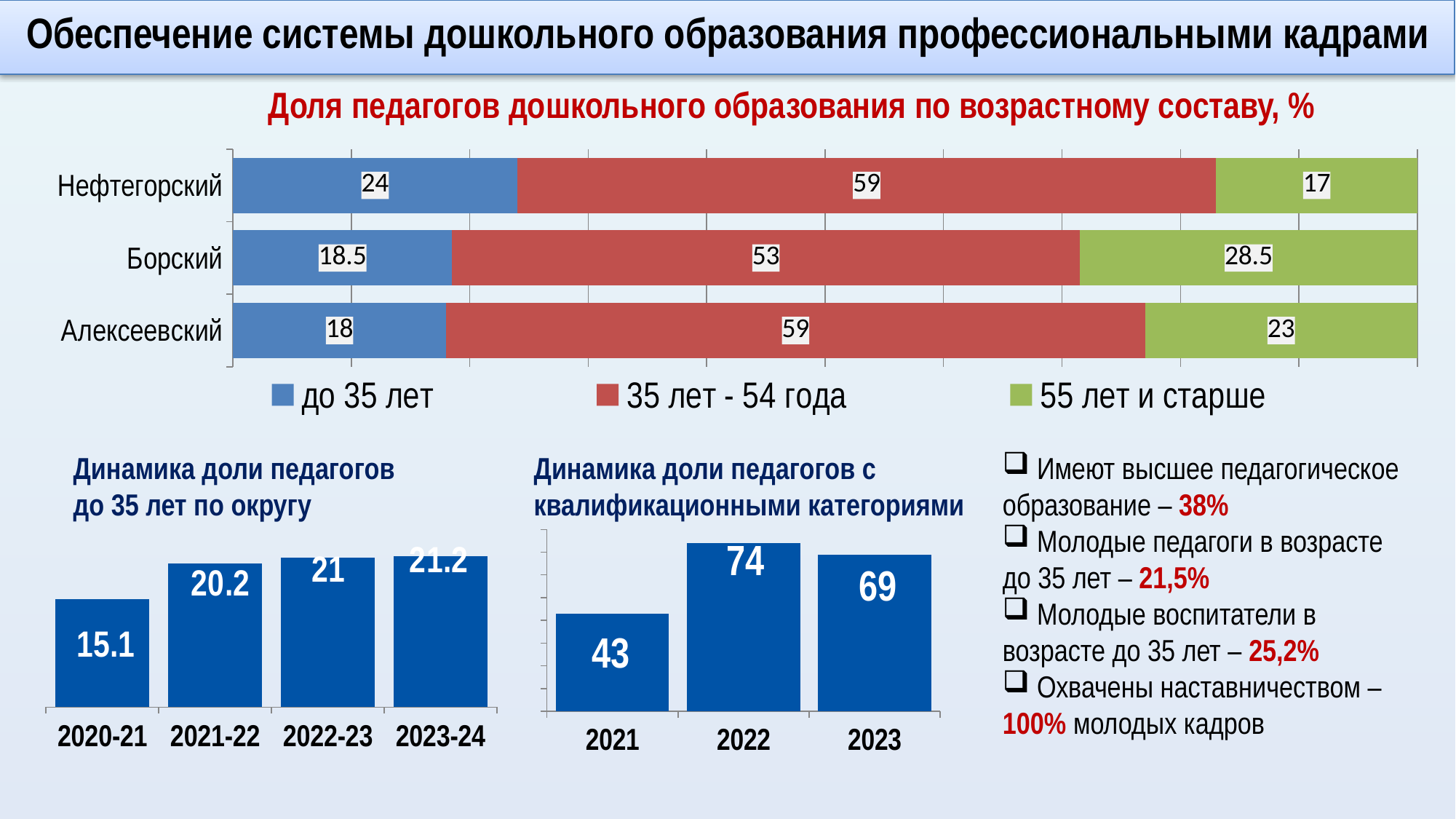
How many bars are in the chart 'Динамика доли педагогов до 35 лет по округу'? 4 In the chart 'Динамика доли педагогов до 35 лет по округу', do the values rise or fall from 2020-21 to 2023-24? Rise In the chart 'Динамика доли педагогов с квалификационными категориями', what is the difference between the values for 2022 and 2021? 31 What type of chart is 'Доля педагогов дошкольного образования по возрастному составу, %'? Stacked bar chart How many series does the legend of the chart 'Доля педагогов дошкольного образования по возрастному составу, %' list? 3 In the chart 'Динамика доли педагогов до 35 лет по округу', what is the value for 2020-21? 15.1 In the chart 'Доля педагогов дошкольного образования по возрастному составу, %', what is the difference between the '35 лет - 54 года' values for Нефтегорский and Борский? 6 In the chart 'Доля педагогов дошкольного образования по возрастному составу, %', which district has the lowest value for 'до 35 лет'? Алексеевский In the chart 'Доля педагогов дошкольного образования по возрастному составу, %', which district has the highest value for '55 лет и старше'? Борский In the chart 'Доля педагогов дошкольного образования по возрастному составу, %', what is the value for 'до 35 лет' in Нефтегорский? 24 In the chart 'Доля педагогов дошкольного образования по возрастному составу, %', what is the value for '55 лет и старше' in Борский? 28.5 In the chart 'Динамика доли педагогов с квалификационными категориями', which year has the highest value? 2022